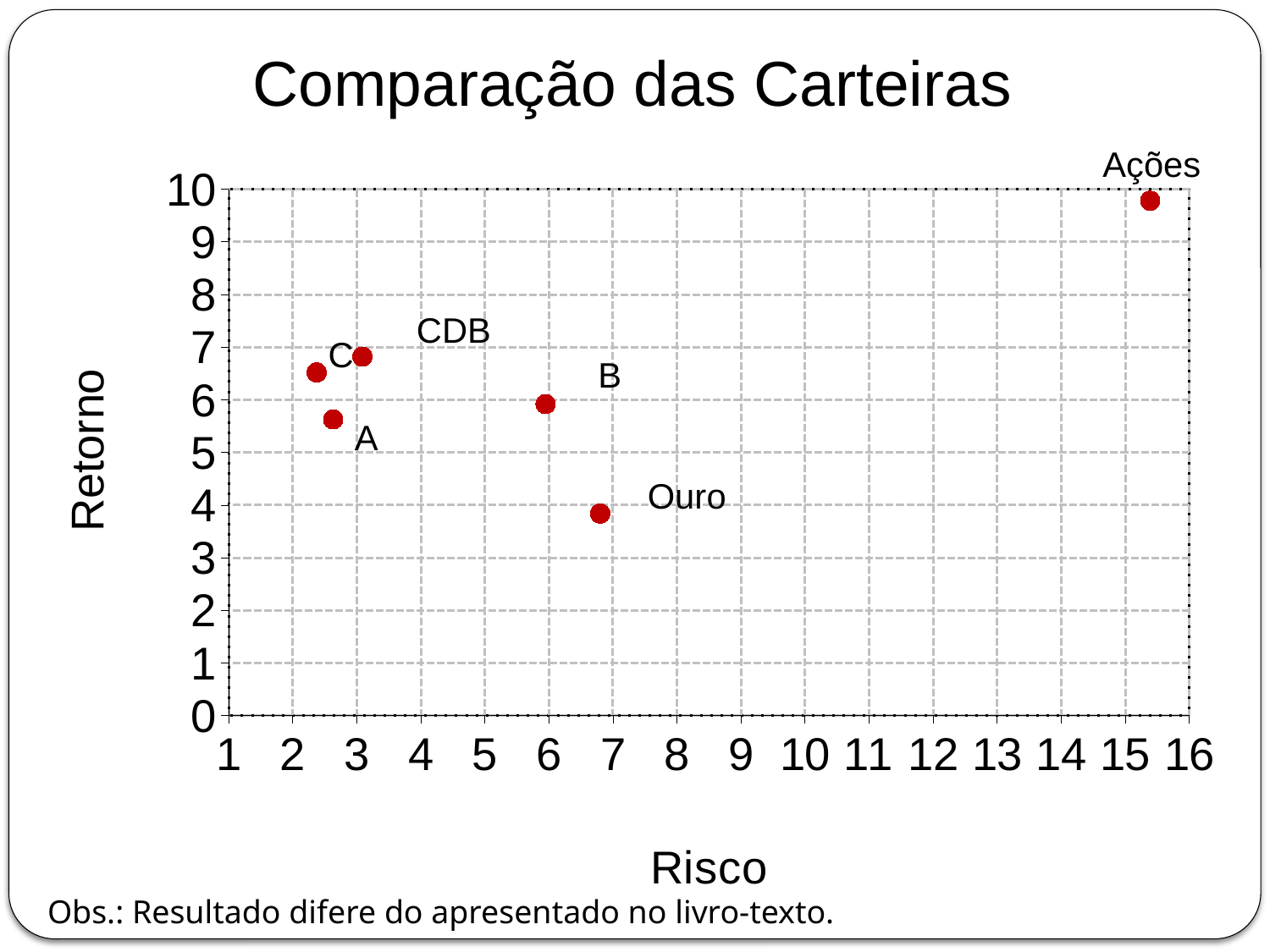
What is the title of the chart? Comparação das Carteiras Which portfolio has the lowest Retorno? Ouro Is the Retorno for Ouro greater or less than 5? less Is the Retorno for Ações greater or less than 9? greater Is the Risco for B greater or less than 5? greater Which has the higher Retorno, B or Ouro? B What kind of chart is shown on the slide? scatter chart Which portfolio has the highest Retorno? Ações How many portfolios (points) are plotted on the chart? 6 What are the labels of the x axis and the y axis? Risco (x axis) and Retorno (y axis) Which portfolio has the highest Risco? Ações